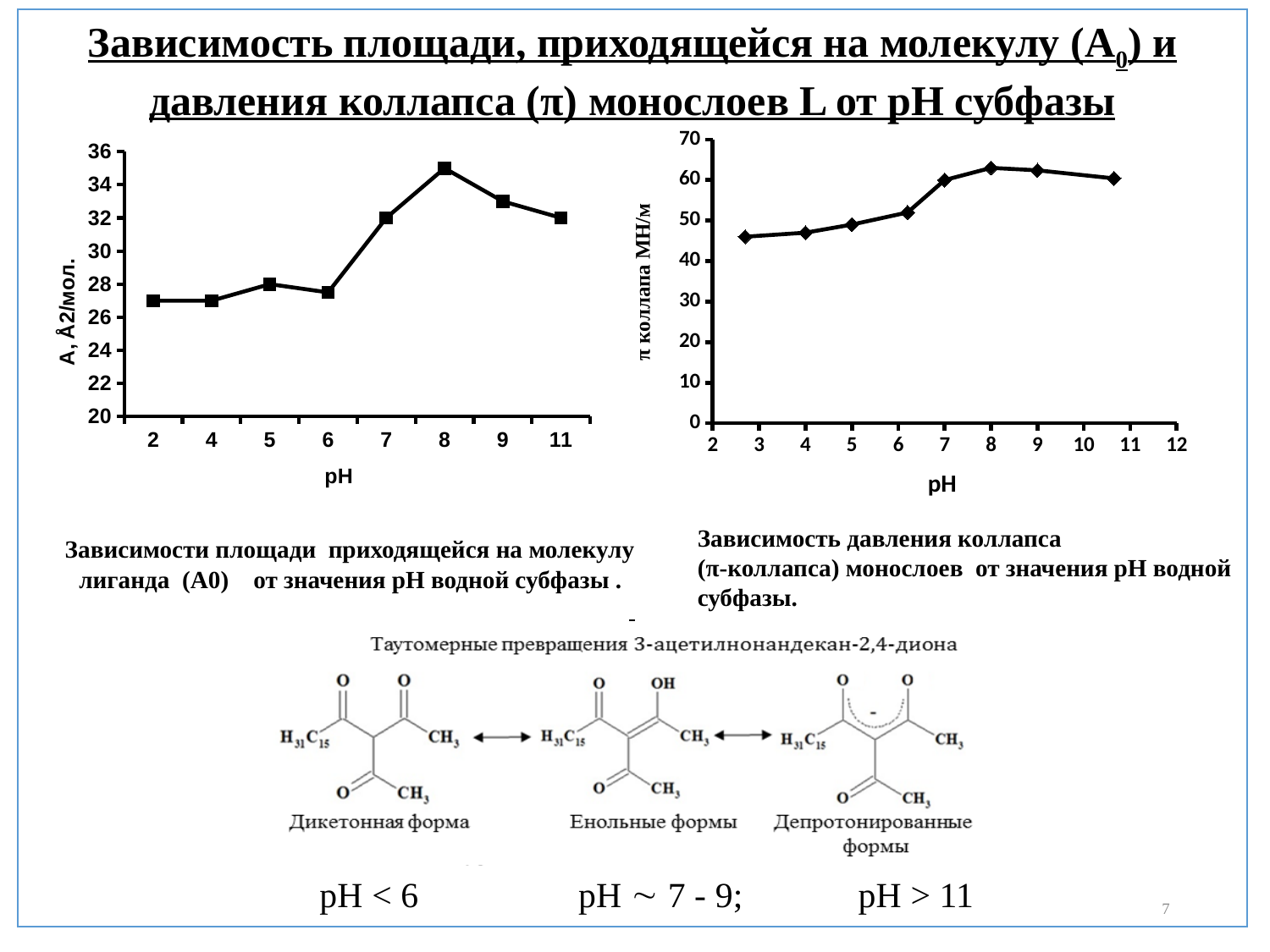
On the left chart (A vs pH), what is the value of A at pH 7? 32 On the right chart (π коллапса vs pH), is the value at pH 4 greater or less than 50? less How many data points are plotted on the left chart (A vs pH)? 8 On the right chart (π коллапса vs pH), what is the collapse pressure at pH 7? 60 On the left chart (A vs pH), which is larger: the value at pH 8 or at pH 9? pH 8 On the left chart (A vs pH), at which pH is the area per molecule highest? 8 What type of chart is the right chart (π коллапса vs pH)? line chart On the right chart (π коллапса vs pH), which is larger: the value at pH 5 or at pH 7? pH 7 On the right chart (π коллапса vs pH), does the collapse pressure generally rise or fall as pH increases from 3 to 8? rise On the right chart (π коллапса vs pH), is the value at pH 8 greater or less than 60? greater On the left chart (A vs pH), is the value at pH 2 greater or less than 28? less On the left chart (A vs pH), what is the value of A at pH 5? 28